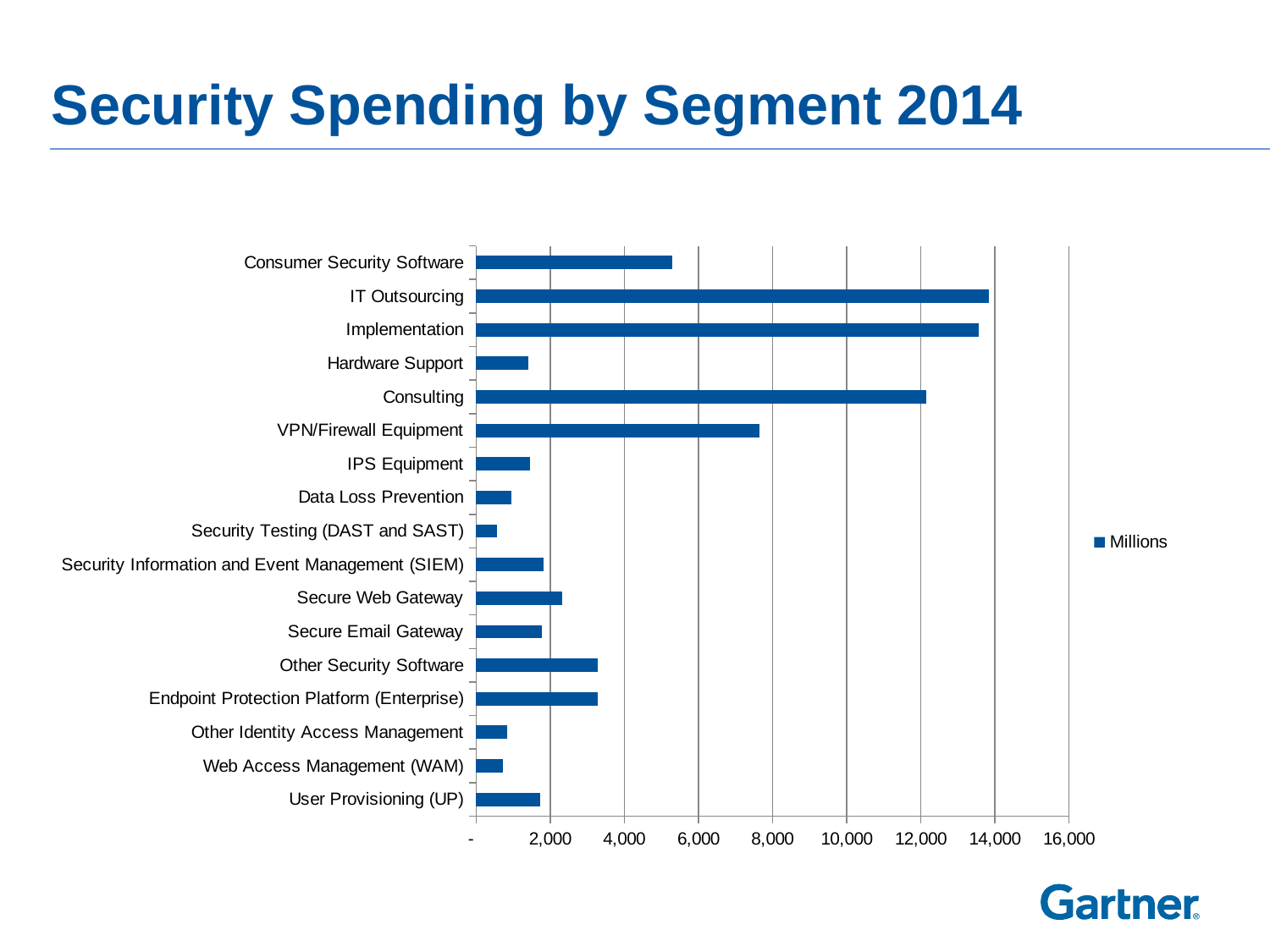
How many series does the legend list? 1 Is the value for Consumer Security Software greater or less than 6,000? less How many segments (categories) are plotted in the chart? 17 Is the value for Consulting greater or less than 14,000? less Is the value for Security Testing (DAST and SAST) greater or less than 2,000? less Which is larger, the value for Secure Web Gateway or the value for Data Loss Prevention? Secure Web Gateway What is the title of the chart on the slide? Security Spending by Segment 2014 What kind of chart is shown on the slide? bar chart Which is larger, the value for Consulting or the value for VPN/Firewall Equipment? Consulting What is the legend entry for the plotted series? Millions